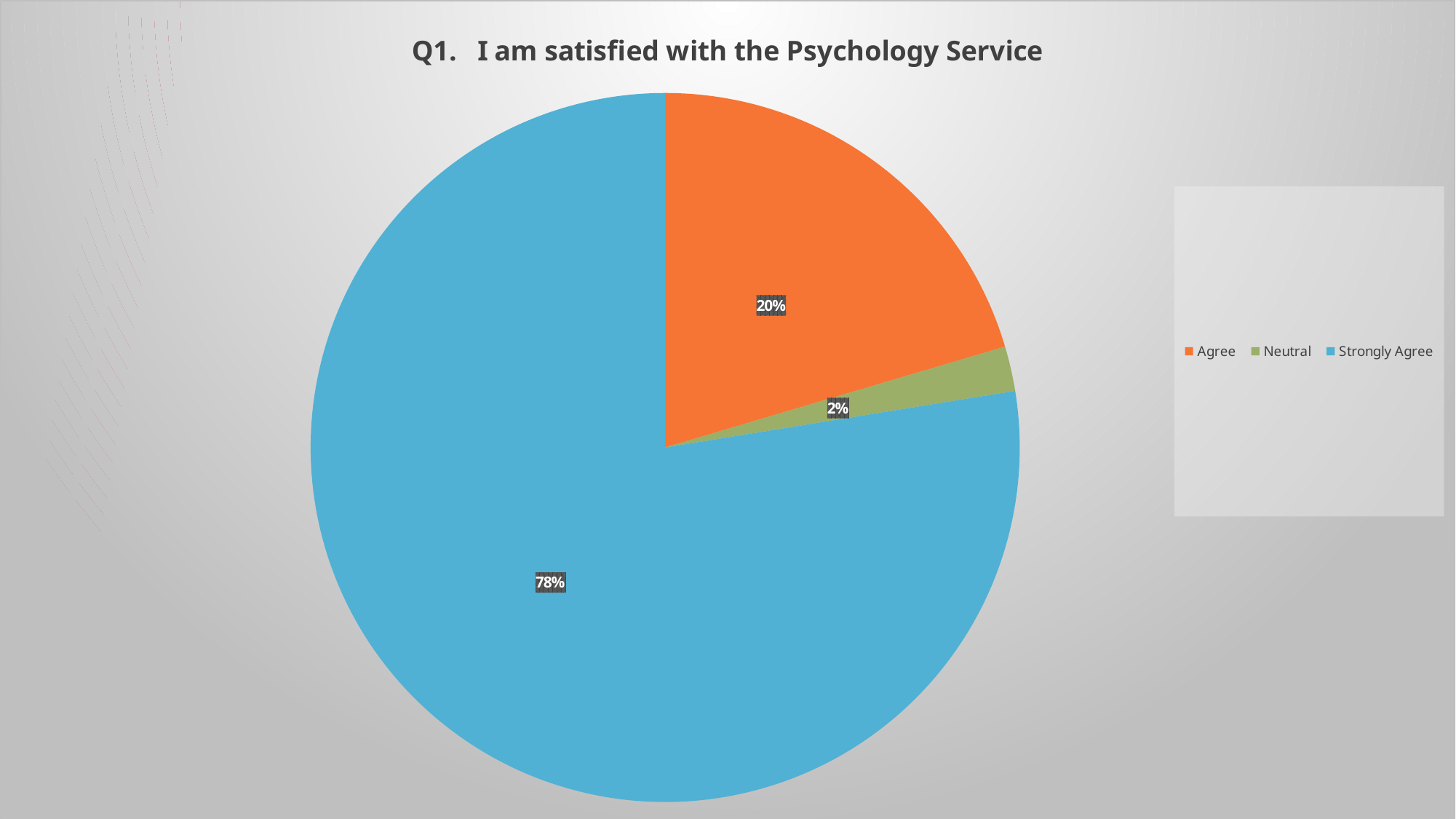
What is the difference in percentage points between Strongly Agree and Agree? 58 How many categories does the legend list? 3 Which category has the largest share of the pie? Strongly Agree What is the title of the chart? Q1. I am satisfied with the Psychology Service What percentage of the pie is labelled for Neutral? 2% What is the combined share of Agree and Neutral? 22% Which is larger, the share for Agree or the share for Neutral? Agree What percentage of the pie is labelled for Agree? 20% Which category has the smallest share of the pie? Neutral What type of chart is shown on the slide? pie chart What percentage of the pie is labelled for Strongly Agree? 78% What colour is the Strongly Agree slice? blue